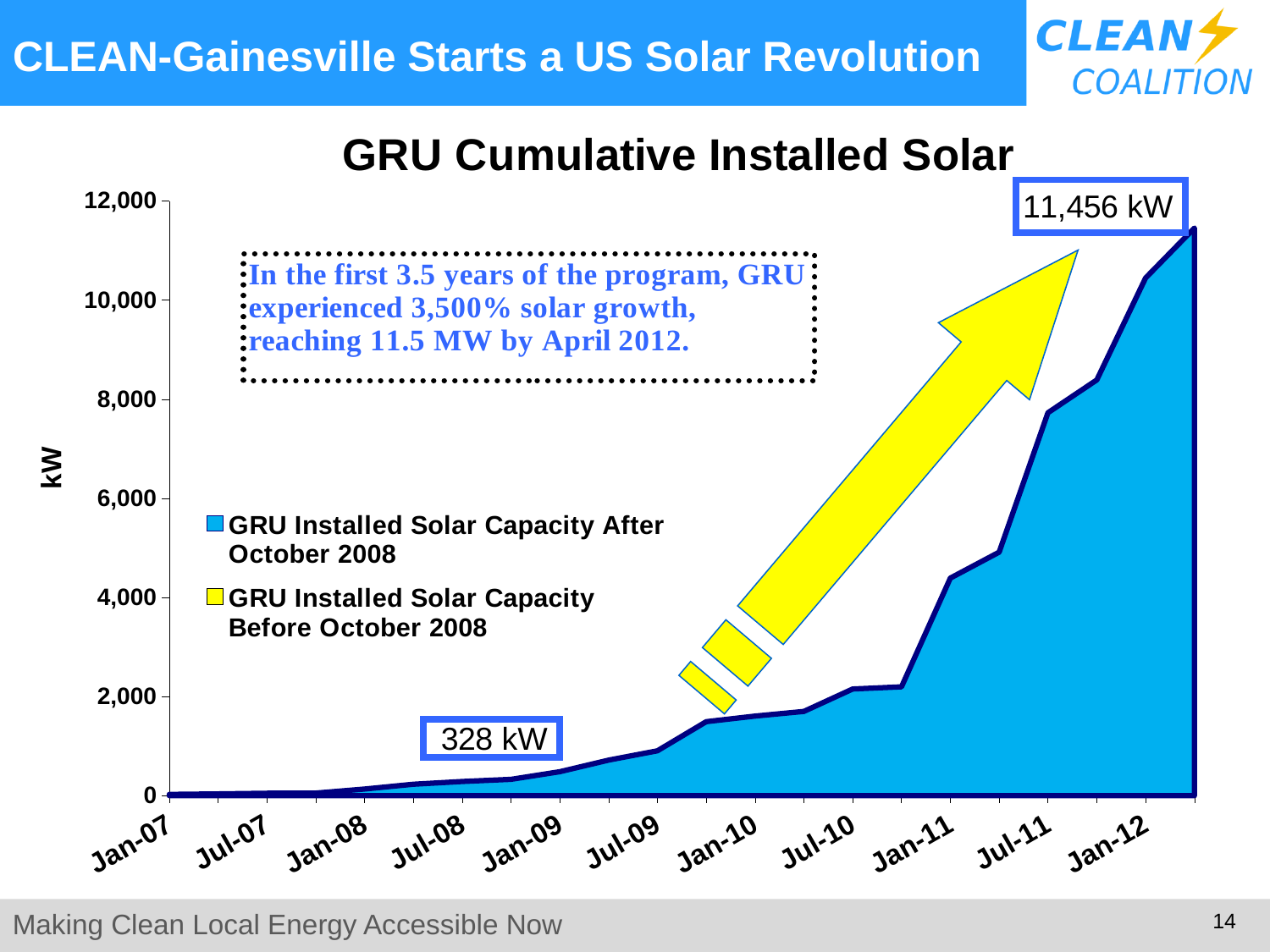
How many date labels are shown on the x axis? 11 Is the value at Jan-10 greater or less than 2,000? less What is the highest value labelled on the chart? 11,456 kW What is the title of the chart? GRU Cumulative Installed Solar What unit is shown on the y-axis label? kW How many series does the chart's legend list? 2 What is the difference between the two labelled values, 11,456 kW and 328 kW? 11,128 kW Do the values rise or fall along the x axis from Jan-07 to Jan-12? Rise What kind of chart is shown on the slide? Area chart Is the value at Jan-11 greater or less than 4,000? greater Is the value at Jul-11 greater or less than 6,000? greater What value is labelled on the chart near Jul-08? 328 kW